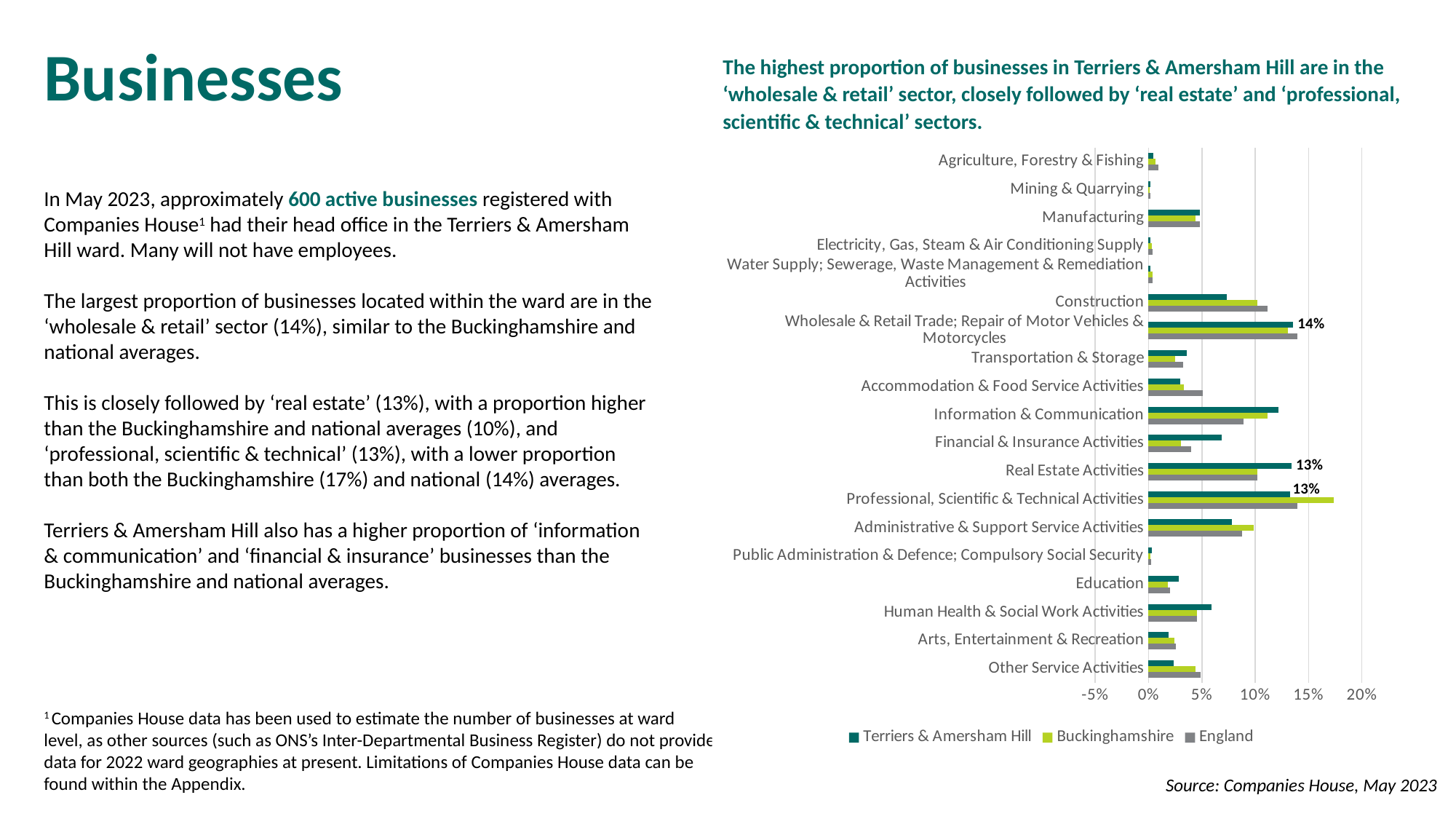
Which category has the highest value for the Terriers & Amersham Hill series? Wholesale & Retail Trade; Repair of Motor Vehicles & Motorcycles What is the value for Terriers & Amersham Hill in the 'Wholesale & Retail Trade; Repair of Motor Vehicles & Motorcycles' category? 14% What is the value for Terriers & Amersham Hill in the 'Professional, Scientific & Technical Activities' category? 13% In the 'Information & Communication' category, which is larger: Terriers & Amersham Hill or England? Terriers & Amersham Hill What kind of chart is shown on the slide? Bar chart How many series does the legend list? 3 What is the value for Terriers & Amersham Hill in the 'Real Estate Activities' category? 13% Is the Terriers & Amersham Hill value for 'Construction' greater or less than 10%? less How many categories are shown on the chart? 19 Is the Buckinghamshire value for 'Professional, Scientific & Technical Activities' greater or less than 15%? greater In the 'Professional, Scientific & Technical Activities' category, which is larger: Buckinghamshire or Terriers & Amersham Hill? Buckinghamshire What is the difference between the Terriers & Amersham Hill values for 'Wholesale & Retail Trade; Repair of Motor Vehicles & Motorcycles' and 'Real Estate Activities'? 1 percentage point